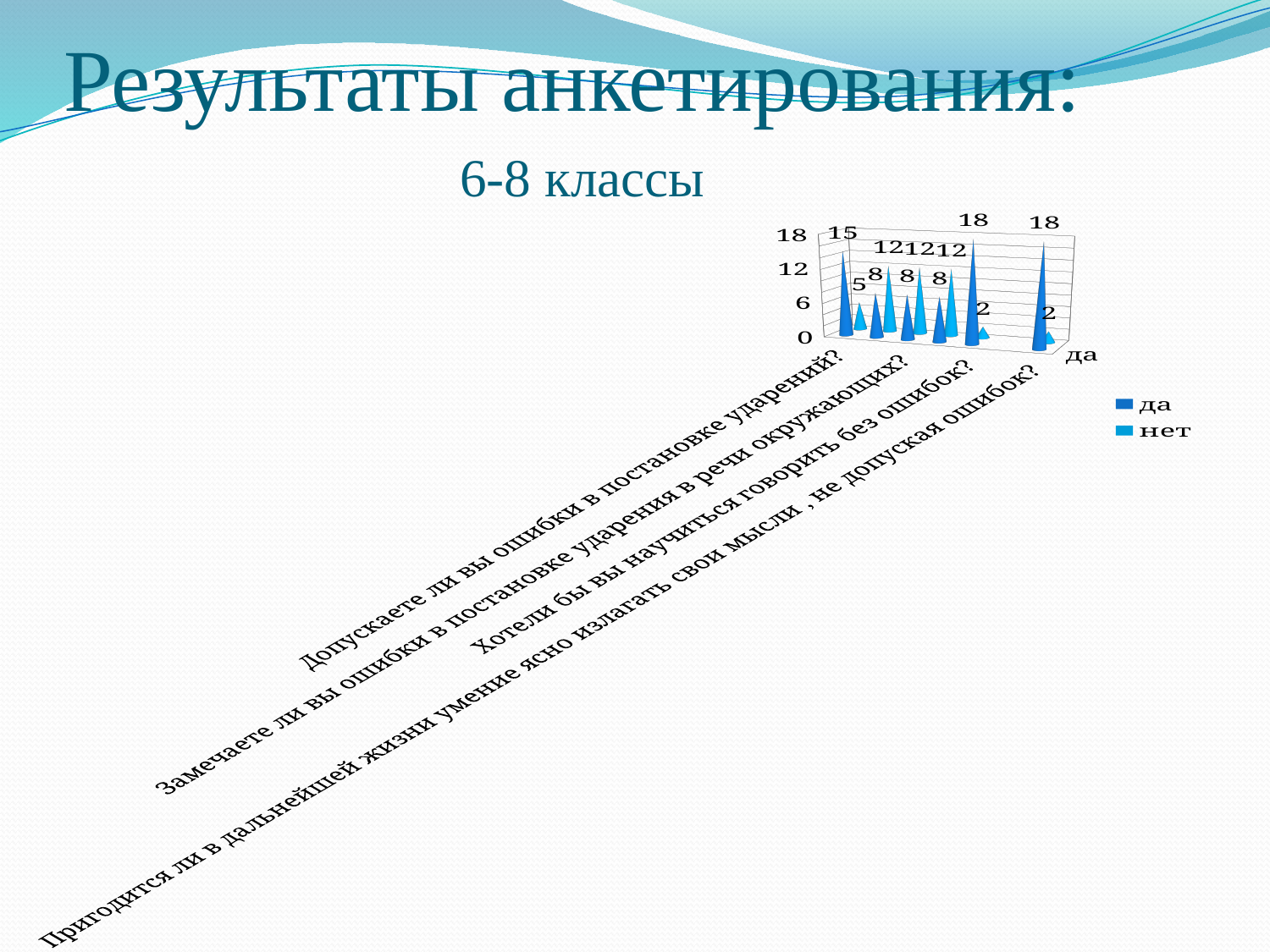
What is the highest value labelled on the chart? 18 What is the 'нет' value for the category 'Допускаете ли вы ошибки в постановке ударений?' 5 What is the lowest value labelled on the chart? 2 What is the 'да' value for the category 'Допускаете ли вы ошибки в постановке ударений?' 15 Is the highest 'да' value on the chart greater or less than 12? greater What is the 'да' value for the category 'Пригодится ли в дальнейшей жизни умение ясно излагать свои мысли, не допуская ошибок?' 18 What is the highest tick value shown on the vertical axis? 18 What kind of chart is shown on the slide? bar chart For 'Допускаете ли вы ошибки в постановке ударений?', which is larger, 'да' or 'нет'? да What is the difference between the 'да' and 'нет' values for 'Допускаете ли вы ошибки в постановке ударений?' 10 What are the two legend entries of the chart? да, нет How many series does the legend list? 2